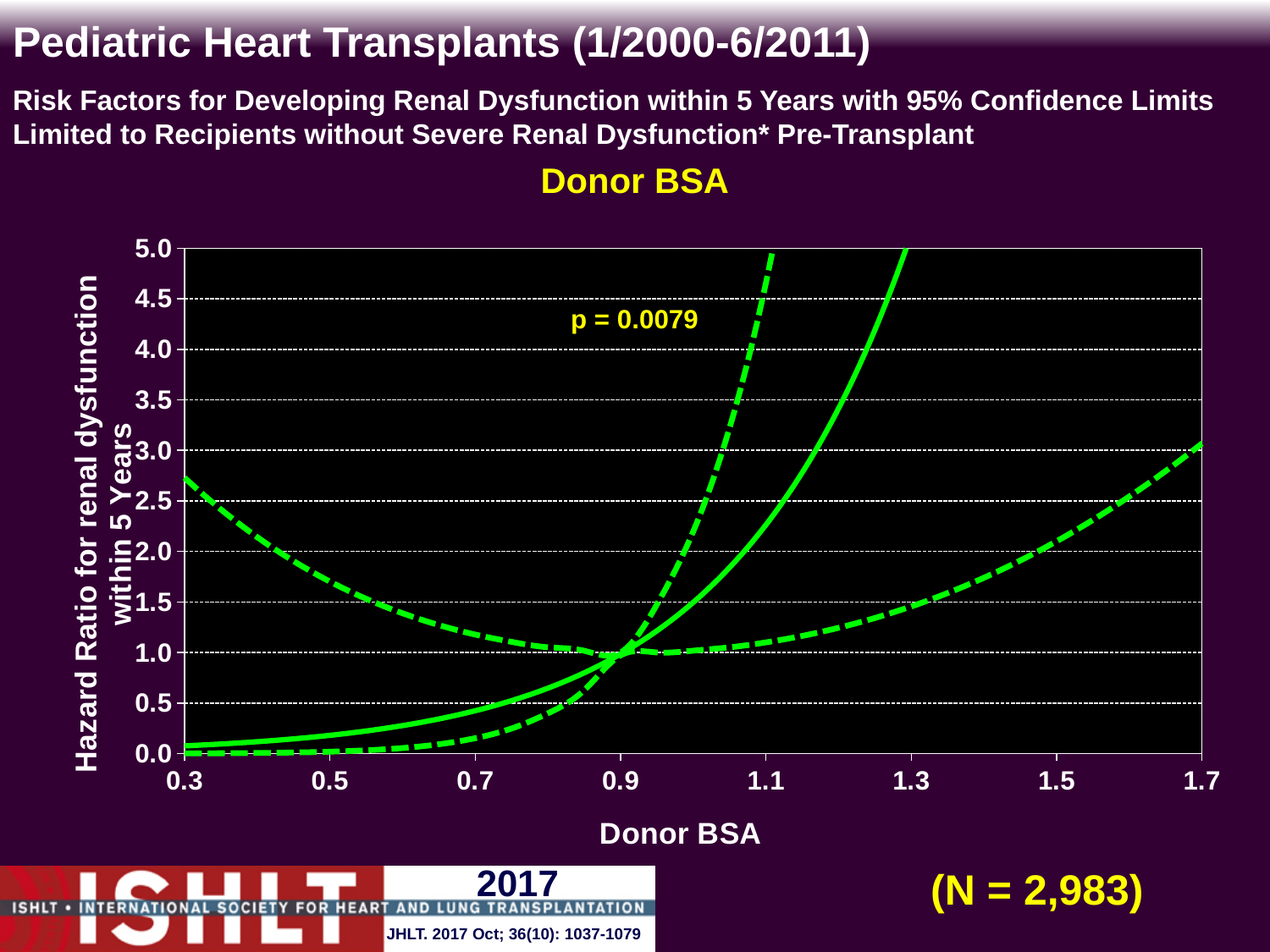
What is the highest value shown on the y axis? 5.0 What is the lowest Donor BSA value shown on the x axis? 0.3 Is the solid hazard ratio line at Donor BSA 0.7 greater or less than 1.0? less Does the solid hazard ratio line rise or fall as Donor BSA increases from 0.3 to 1.3? rise What kind of chart is shown on the slide? line chart What is the label of the x axis? Donor BSA How many lines are plotted on the chart? 3 What is the p-value printed on the chart? p = 0.0079 Is the solid hazard ratio line at Donor BSA 1.2 greater or less than 2.5? greater Is the solid hazard ratio line at Donor BSA 0.5 greater or less than 0.5? less